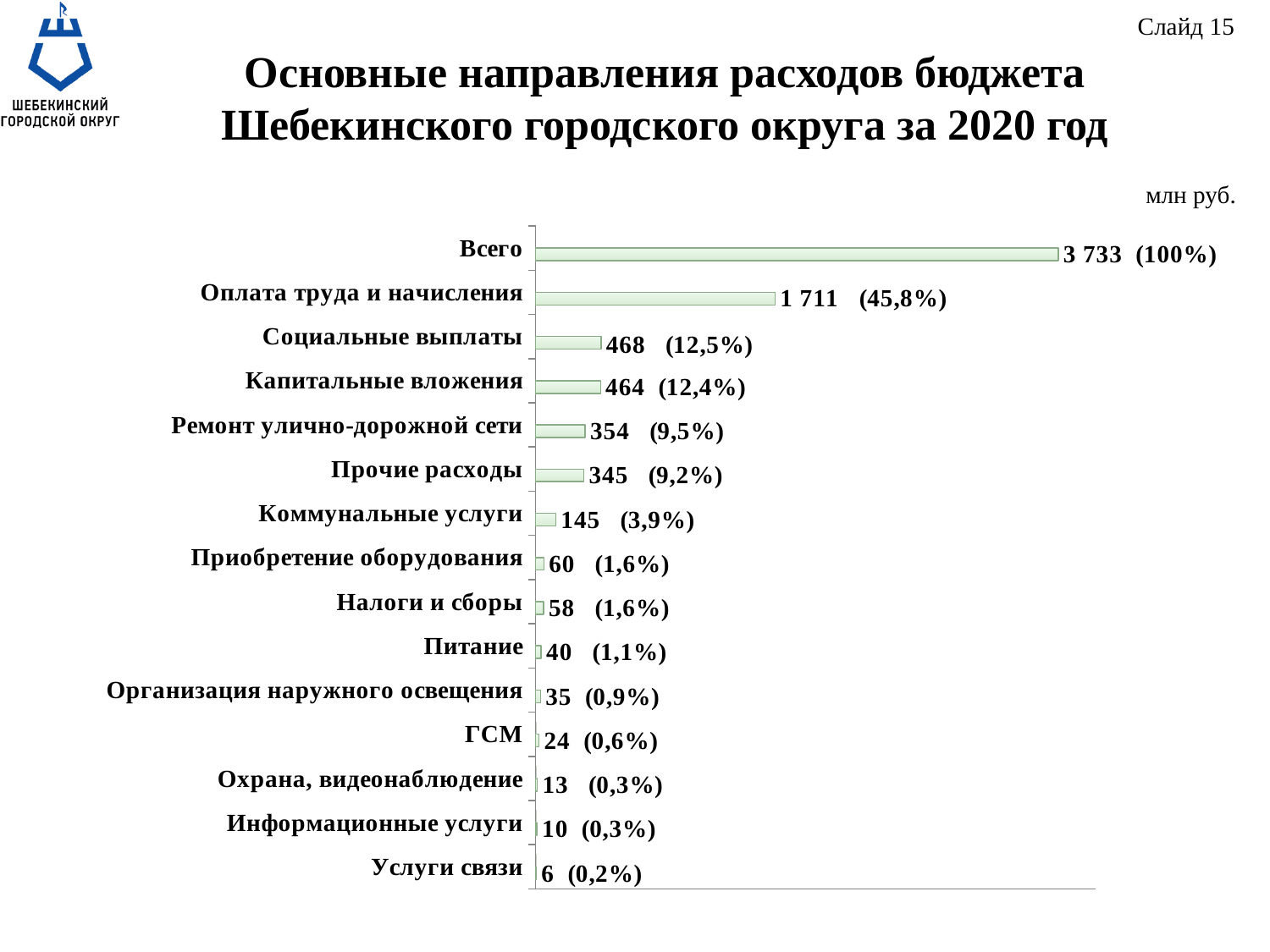
What is the value for Ремонт улично-дорожной сети? 354 What percentage share is shown for Социальные выплаты? 12,5% What is the value for Услуги связи? 6 What is the value for Оплата труда и начисления? 1 711 What kind of chart is shown on the slide? Bar chart What is the difference between Оплата труда и начисления and Социальные выплаты? 1 243 Which category has the lowest value? Услуги связи What is the value shown for Всего? 3 733 Excluding the Всего bar, which category has the highest value? Оплата труда и начисления What is the difference between Социальные выплаты and Капитальные вложения? 4 How many bars are plotted on the chart, including Всего? 15 Which is larger, Ремонт улично-дорожной сети or Прочие расходы? Ремонт улично-дорожной сети